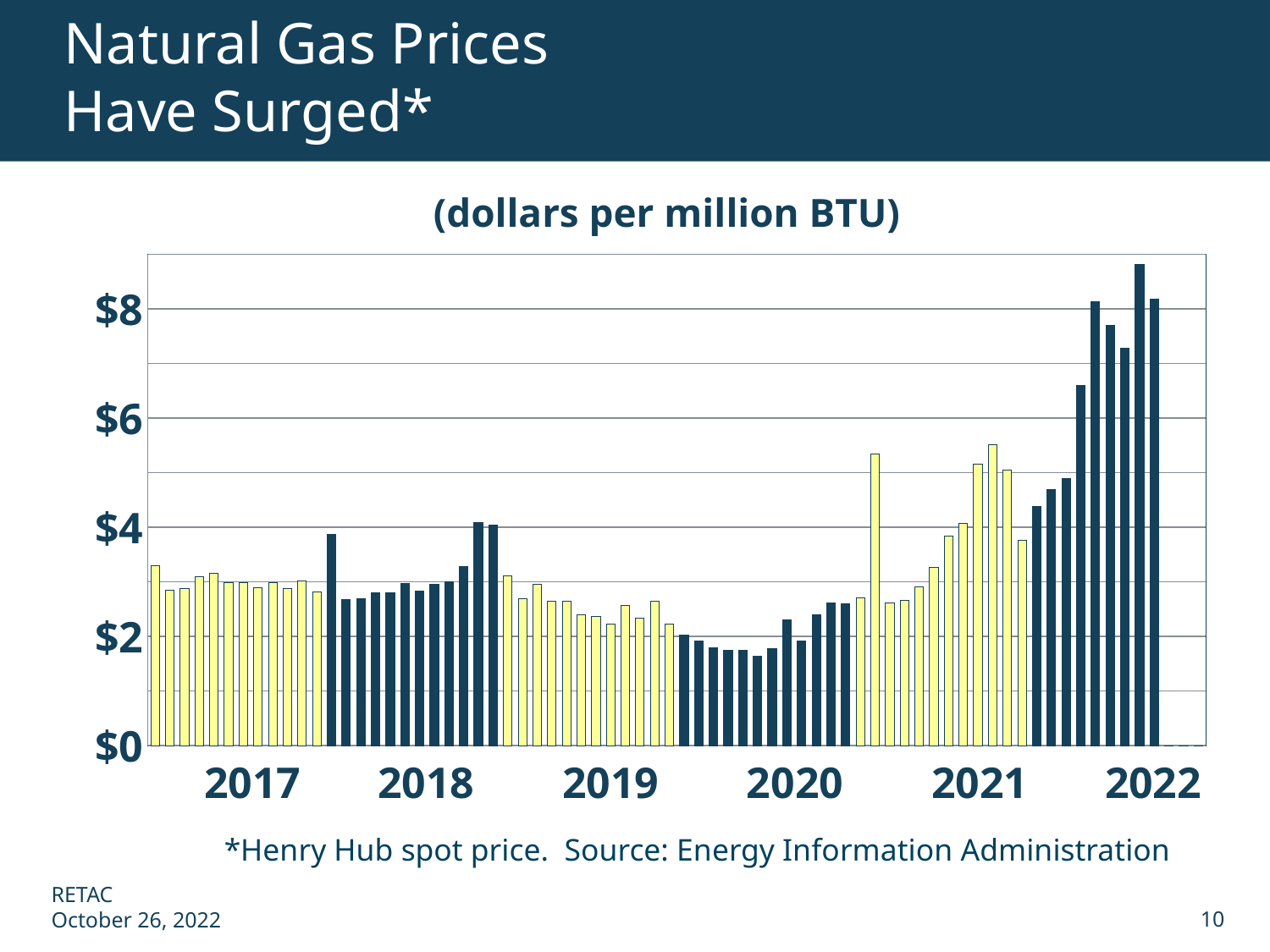
According to the footnote, what is the source of the data? Energy Information Administration In which year does the chart reach its highest bar? 2022 What unit is given in the chart's subtitle? dollars per million BTU Is the tallest bar in 2018 greater or less than $6? less Are the bars for 2017 greater or less than $4? less What is the highest value labeled on the vertical axis? $8 In which year do the lowest bars on the chart appear? 2020 Is the tallest bar in 2022 greater or less than $8? greater Which year has higher prices overall, 2017 or 2022? 2022 What kind of chart is shown on the slide? bar chart Do natural gas prices rise or fall from 2020 to 2022? rise